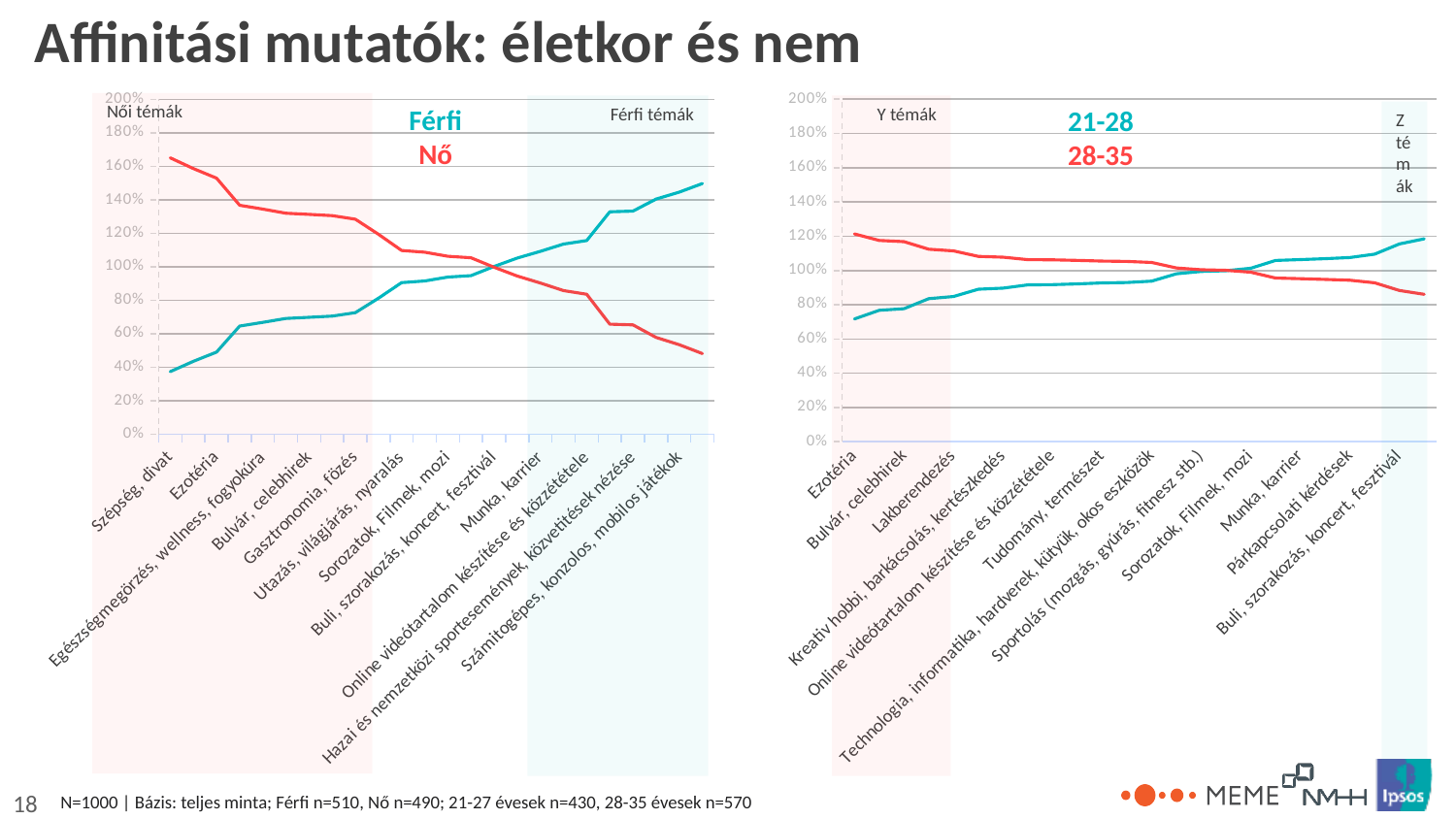
In the left chart, which series has the higher value for Számítógépes, konzolos, mobilos játékok, Férfi or Nő? Férfi In the left chart, which series has the higher value for Szépség, divat, Férfi or Nő? Nő In the right chart, is the value of the 21-28 series for Ezotéria greater or less than 80%? less In the left chart, does the Nő series rise or fall from left to right along the x axis? fall What kind of chart is the left chart (Férfi / Nő)? line chart In the right chart, does the 21-28 series rise or fall from left to right along the x axis? rise In the left chart, is the value of the Nő series for Szépség, divat greater or less than 140%? greater In the right chart, is the value of the 28-35 series for Ezotéria greater or less than 100%? greater In the left chart, what colour is the Nő series line? red How many series does the legend of the right chart list? 2